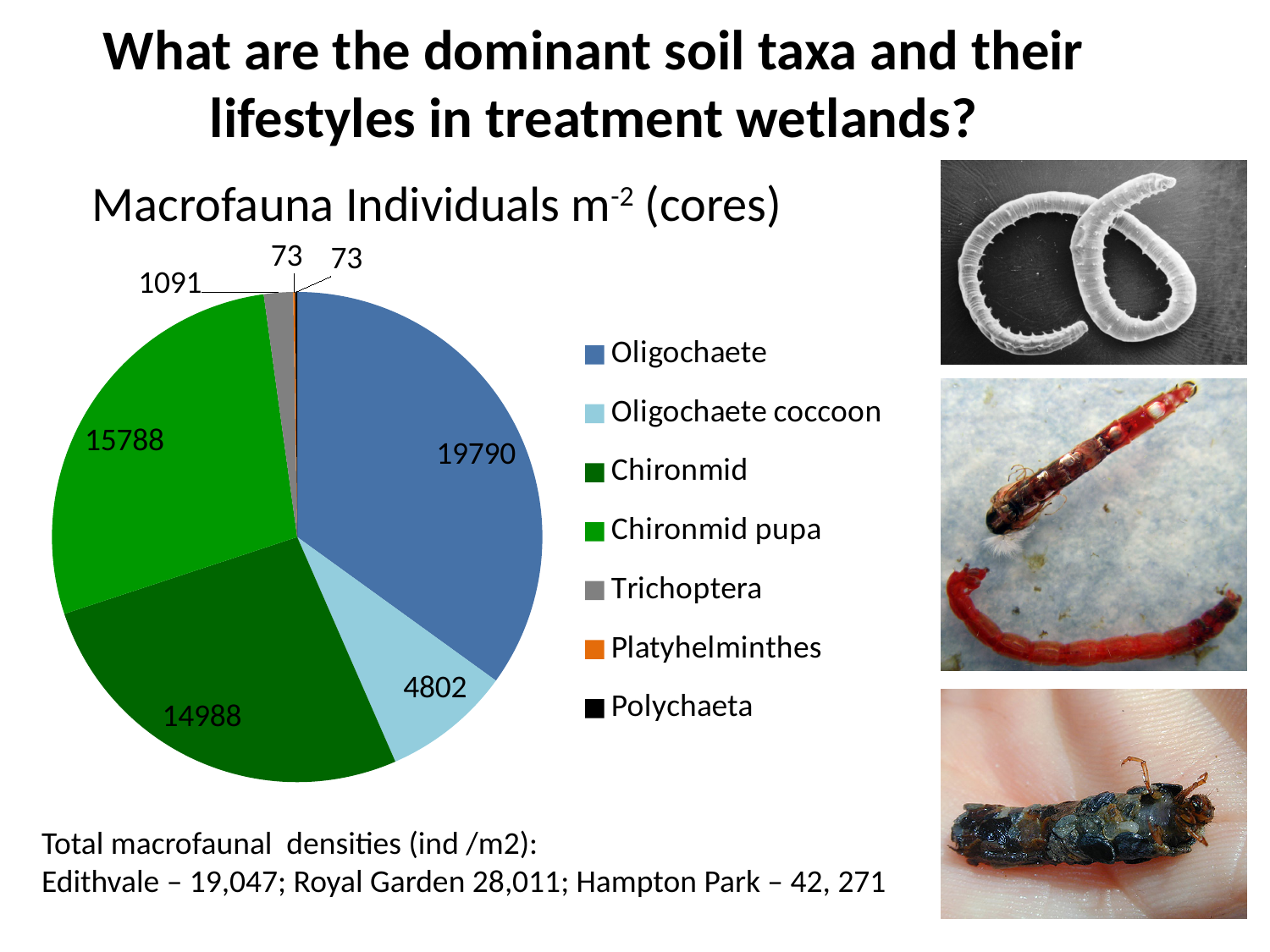
What is the value for Chironmid in the pie chart? 14988 What is the value for Chironmid pupa in the pie chart? 15788 How many categories does the pie chart's legend list? 7 What kind of chart is shown on the slide? Pie chart Which category has the largest slice in the pie chart? Oligochaete What is the title of the chart? Macrofauna Individuals m-2 (cores) What is the value for Oligochaete in the pie chart? 19790 What is the difference between the values for Chironmid pupa and Chironmid? 800 Which is larger, the value for Chironmid or the value for Oligochaete coccoon? Chironmid What is the value for Oligochaete coccoon in the pie chart? 4802 What is the value for Trichoptera in the pie chart? 1091 What is the difference between the values for Oligochaete and Chironmid pupa? 4002